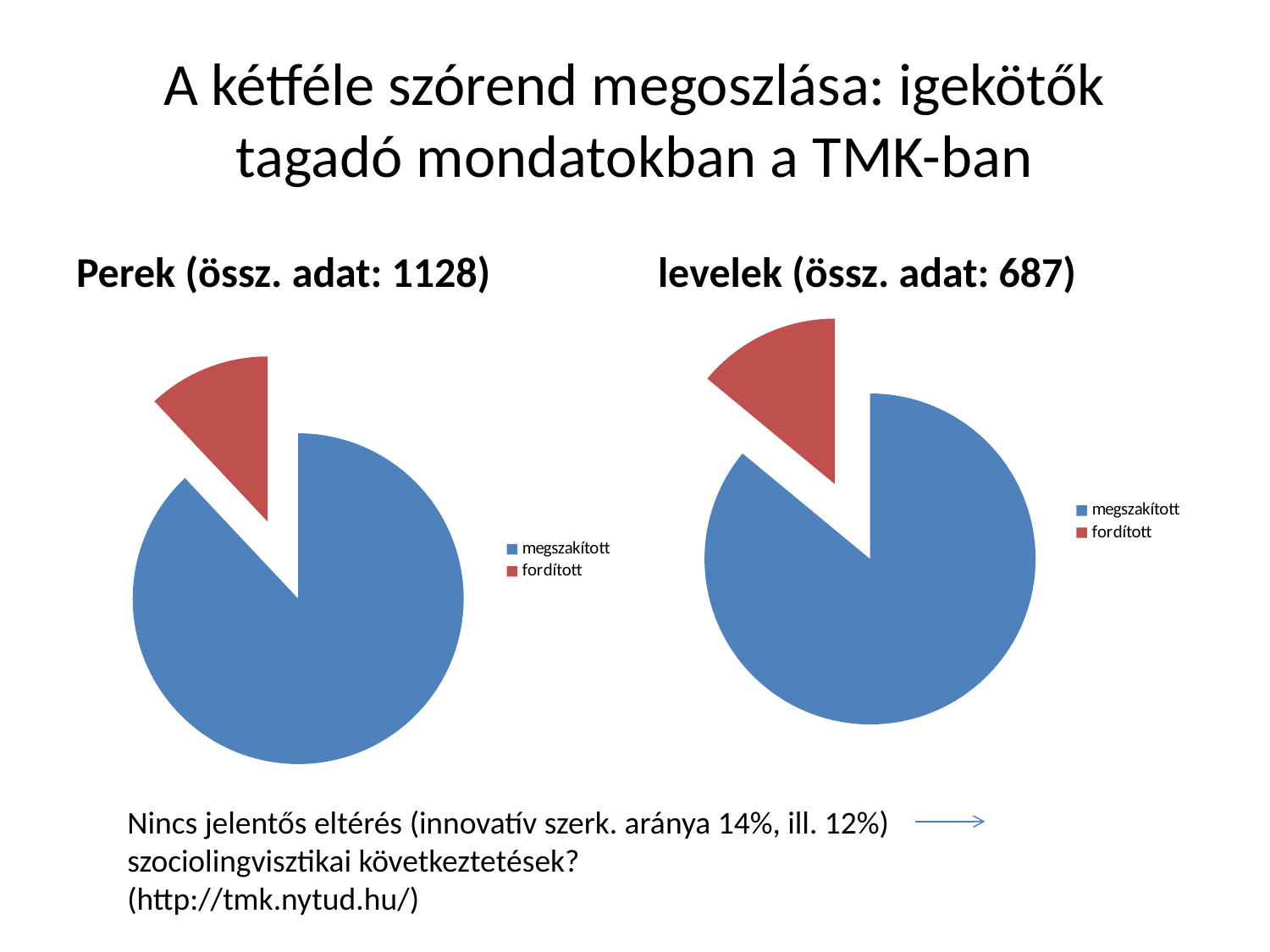
What kind of chart is the left chart titled "Perek (össz. adat: 1128)"? pie chart In the right chart "levelek (össz. adat: 687)", which slice is the smallest? fordított How many slices does the left chart "Perek (össz. adat: 1128)" have? 2 What kind of chart is the right chart titled "levelek (össz. adat: 687)"? pie chart In the left chart "Perek (össz. adat: 1128)", which slice is the smallest? fordított What is the title of the right chart? levelek (össz. adat: 687) In the left chart "Perek (össz. adat: 1128)", what colour is the fordított slice? red In the left chart "Perek (össz. adat: 1128)", which is larger, megszakított or fordított? megszakított How many entries does the legend of the right chart "levelek (össz. adat: 687)" list? 2 In the right chart "levelek (össz. adat: 687)", which is larger, fordított or megszakított? megszakított In the right chart "levelek (össz. adat: 687)", which slice is the largest? megszakított In the left chart "Perek (össz. adat: 1128)", which slice is the largest? megszakított